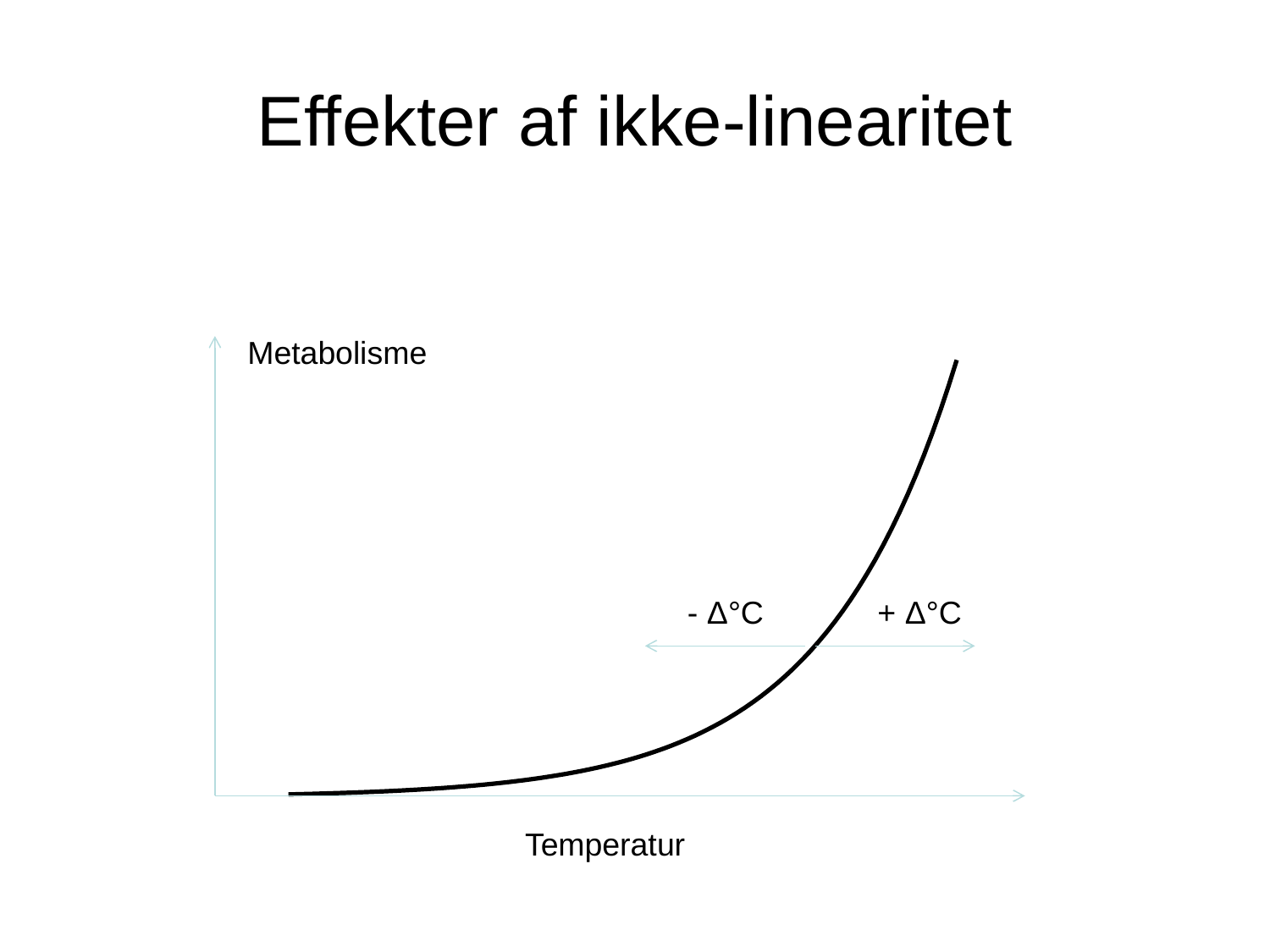
What is the label of the horizontal axis? Temperatur Is the curve steeper at the right end or the left end of the x axis? right end What kind of chart is shown on the slide? line chart Does the curve rise or fall as temperature increases along the x axis? rises What is the label of the vertical axis? Metabolisme